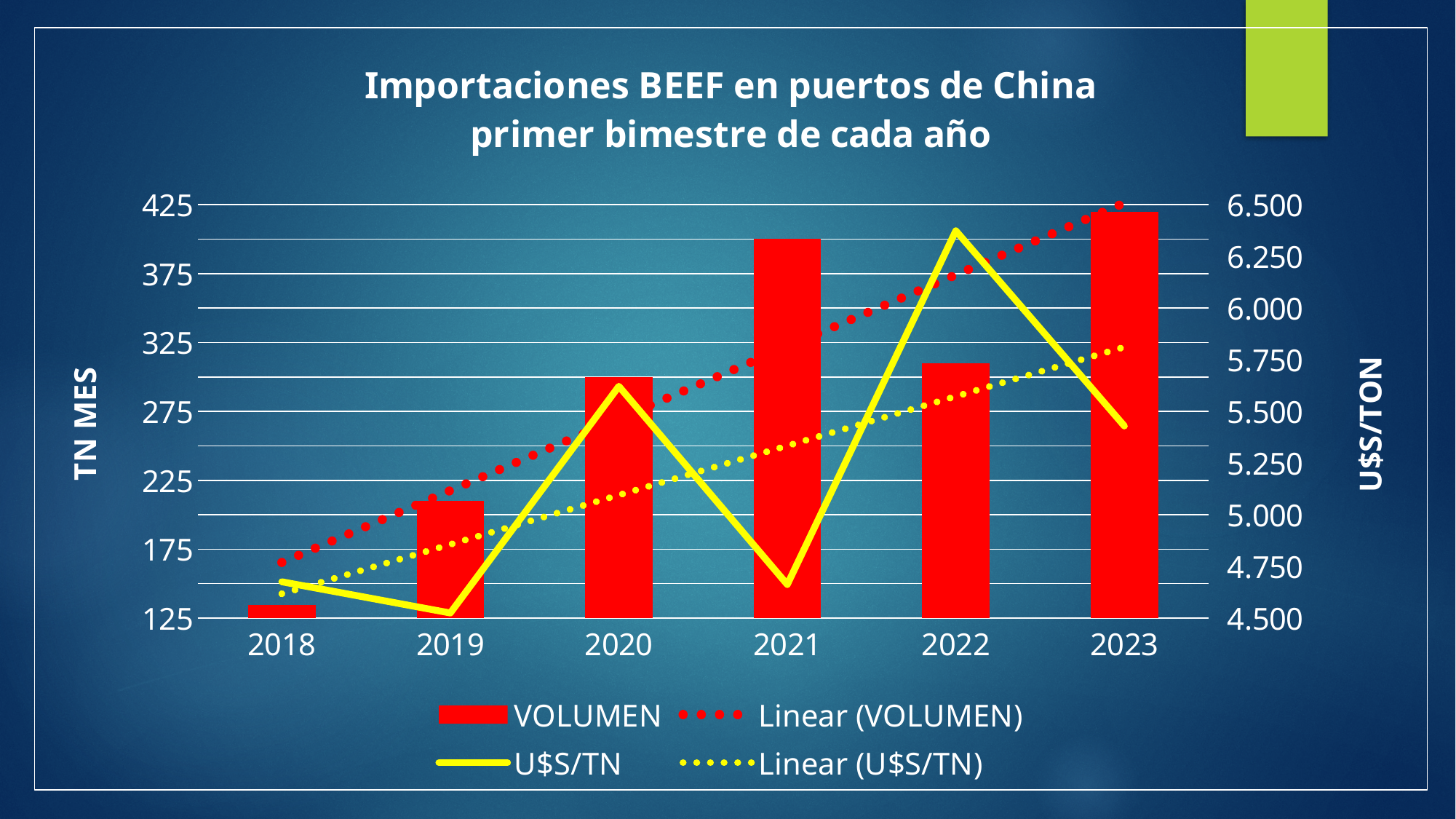
How many entries does the chart's legend list? 4 Which year has the highest VOLUMEN bar? 2023 Is the VOLUMEN value for 2018 greater or less than 175? less In which year does the U$S/TN line reach its highest point? 2022 Does the Linear (VOLUMEN) trend line rise or fall from 2018 to 2023? rise What is the label of the right-hand vertical axis? U$S/TON What kind of chart is shown on the slide? A combined bar and line chart Which year has the lowest VOLUMEN bar? 2018 Is the VOLUMEN value for 2021 greater or less than 375? greater Is the U$S/TN value for 2022 greater or less than 6.000? greater Which year has the higher U$S/TN value, 2020 or 2021? 2020 How many years are shown on the x axis of the chart? 6